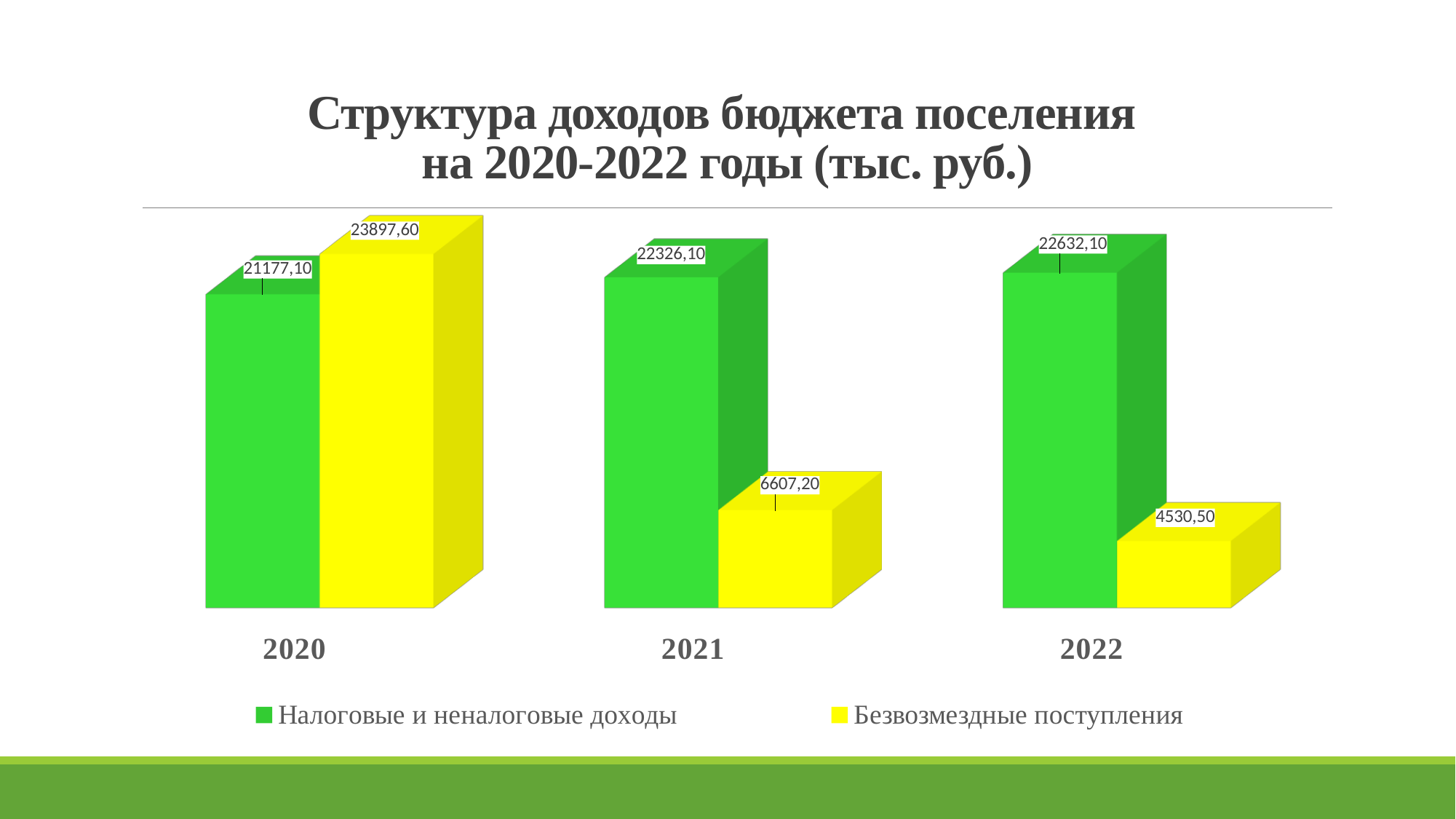
In which year is Безвозмездные поступления lowest? 2022 What is the difference between Безвозмездные поступления and Налоговые и неналоговые доходы in 2020? 2720,50 How many series does the legend list? 2 What is the value for Безвозмездные поступления in 2021? 6607,20 Do the values for Безвозмездные поступления rise or fall from 2020 to 2022? Fall What is the value for Налоговые и неналоговые доходы in 2020? 21177,10 How many years are shown on the x axis? 3 By how much did Налоговые и неналоговые доходы increase from 2020 to 2022? 1455,00 What is the value for Безвозмездные поступления in 2022? 4530,50 Which is larger in 2021: Налоговые и неналоговые доходы or Безвозмездные поступления? Налоговые и неналоговые доходы What kind of chart is shown on the slide? Bar chart In which year is Безвозмездные поступления highest? 2020